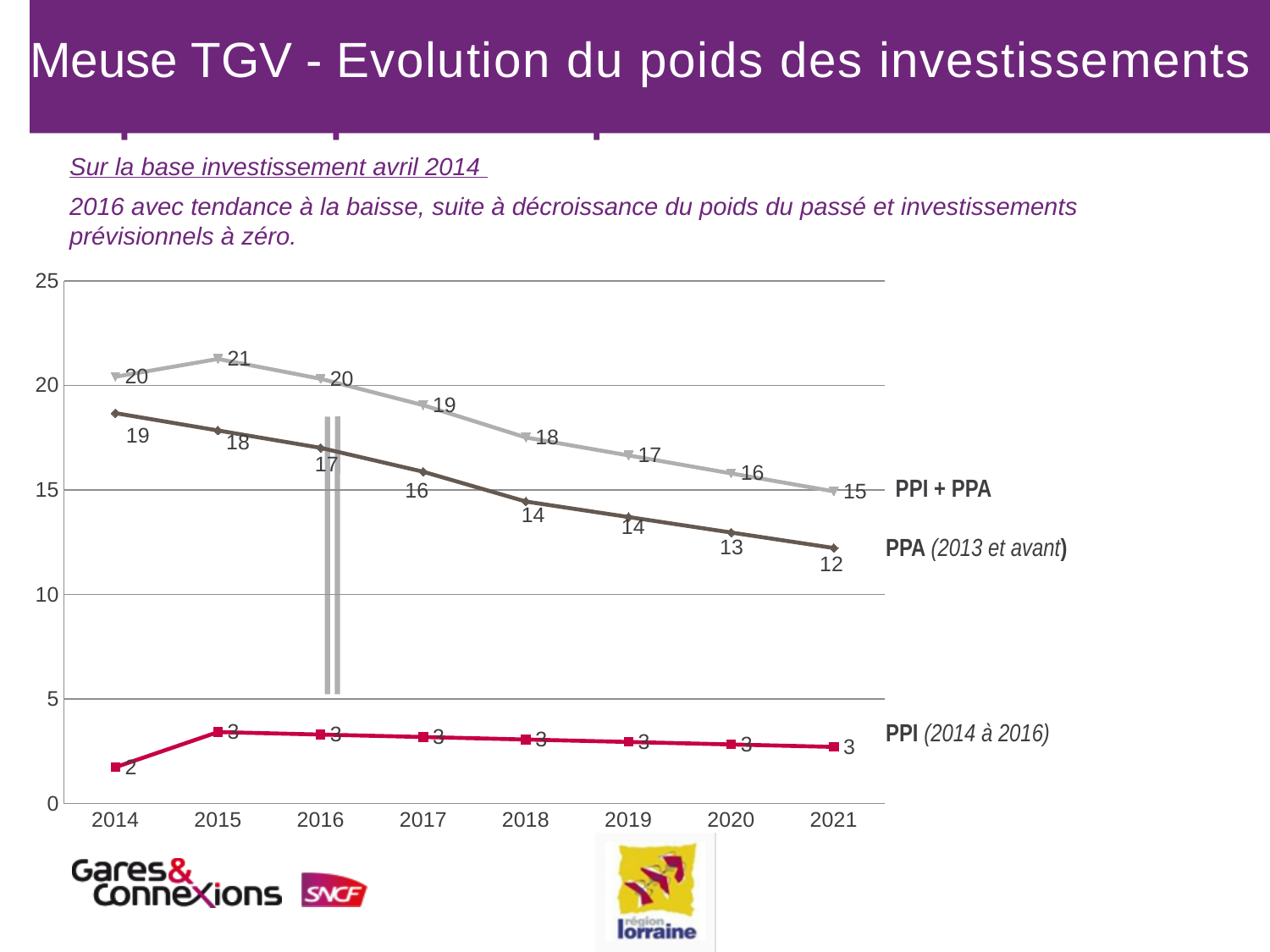
What is the value of the PPA (2013 et avant) series in 2021? 12 What is the value of the PPI + PPA series in 2015? 21 How many years are shown on the x axis? 8 Does the PPI + PPA series rise or fall from 2015 to 2021? fall In which year does the PPI + PPA series reach its highest value? 2015 What type of chart is shown on the slide? line chart Which is larger in 2018: the PPI + PPA value or the PPA (2013 et avant) value? PPI + PPA Is the PPA (2013 et avant) value in 2019 greater or less than 15? less How many series are plotted on the chart? 3 In which year is the PPA (2013 et avant) series at its lowest value? 2021 What is the difference between the PPI + PPA value in 2014 and in 2021? 5 What is the value of the PPI (2014 à 2016) series in 2014? 2